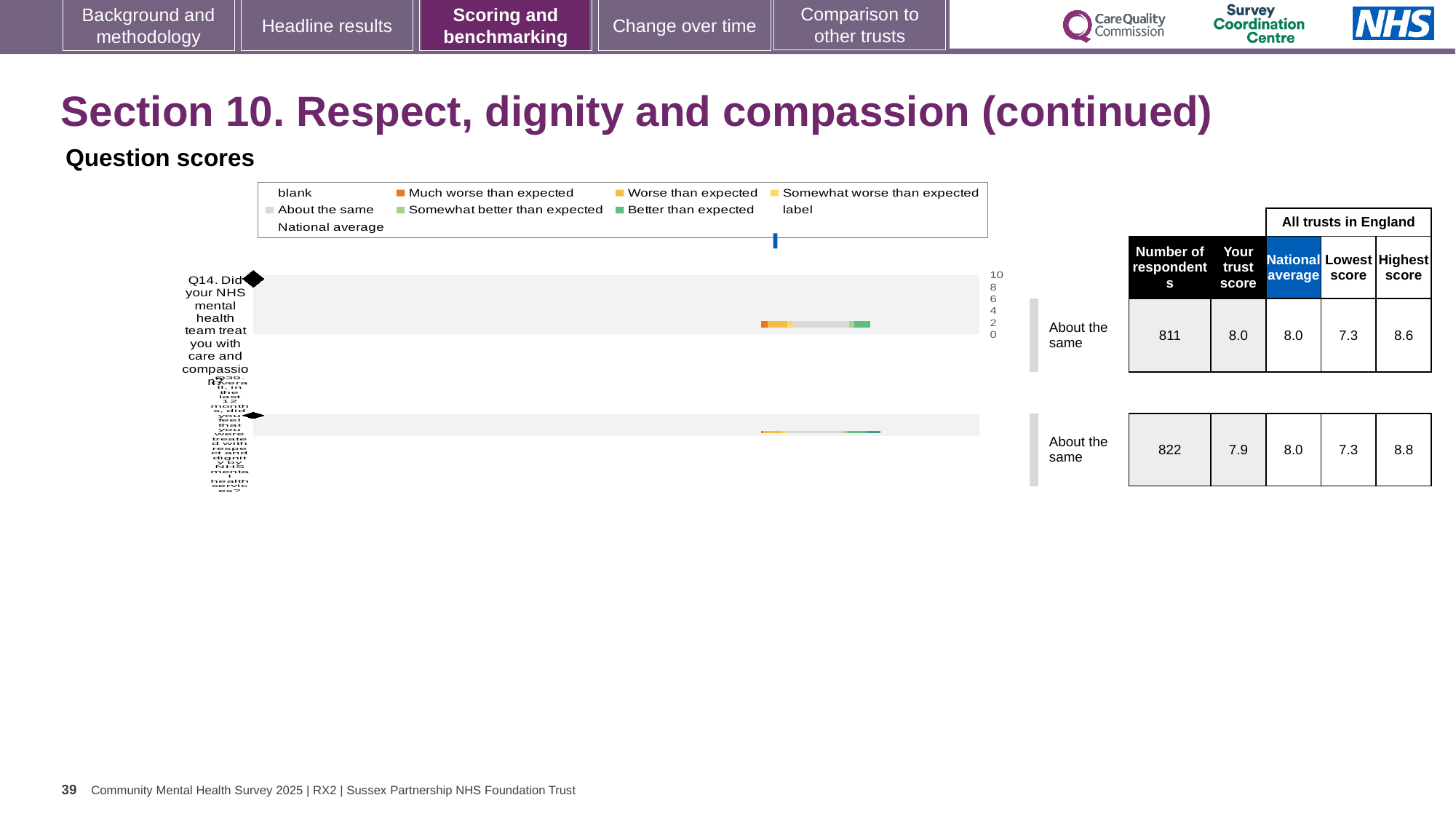
In the table beside the chart, how many respondents answered the second question (bottom row)? 822 What is the highest tick value shown on the chart's score axis? 10 How many question bars are plotted in the chart? 2 What colour does the legend use for 'Much worse than expected'? orange In the table beside the chart, what is the trust score for Q14 (care and compassion)? 8.0 How many entries does the chart legend list? 9 What is the difference between the highest score and the lowest score for Q14 in the table? 1.3 What kind of chart is shown on the slide? bar chart In the table beside the chart, what is the highest score for the second question (bottom row)? 8.8 Which row in the table has more respondents, Q14 or the second question? the second question (822) In the table beside the chart, how many respondents answered Q14? 811 What benchmark category is shown next to the Q14 bar? About the same